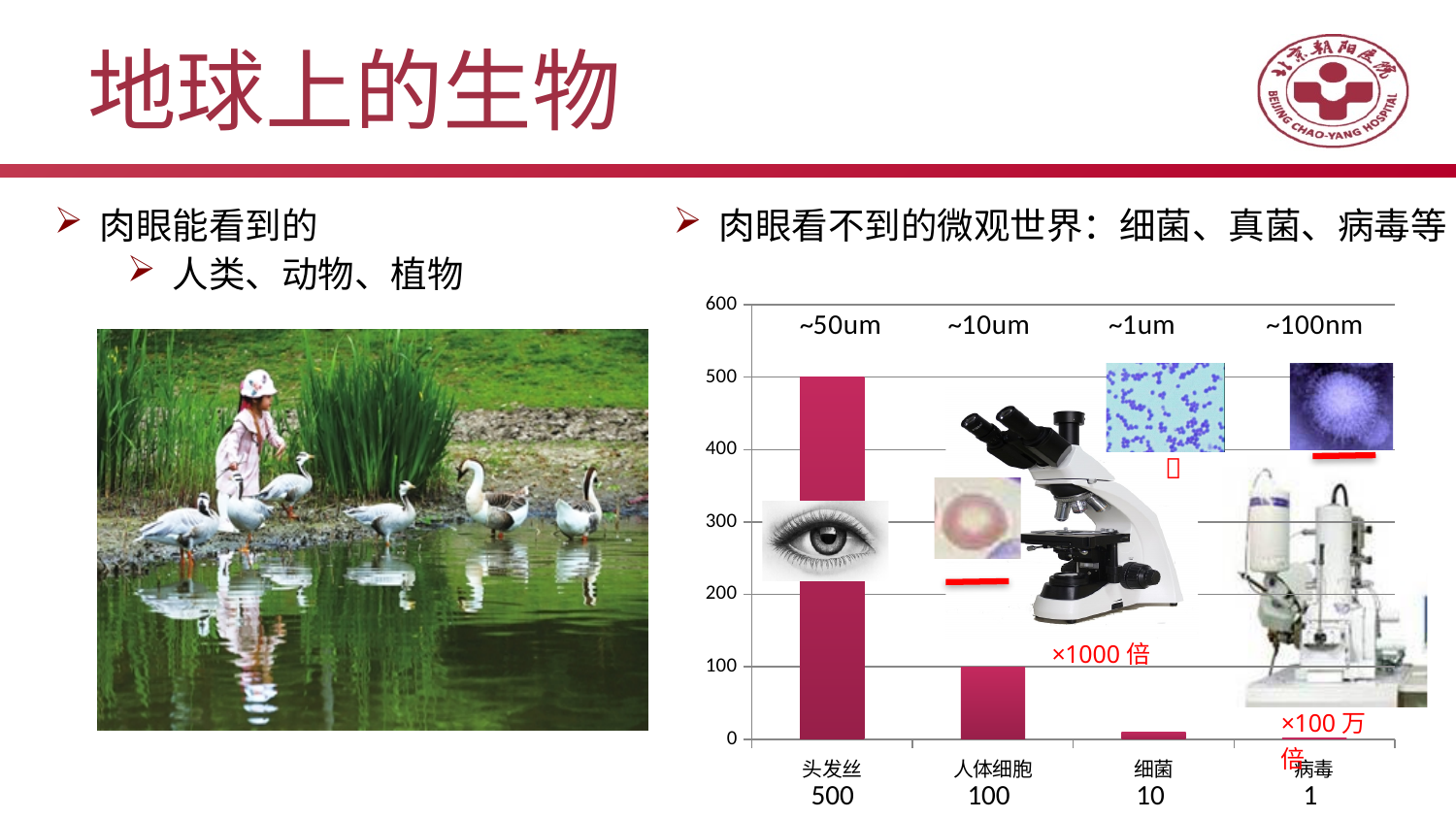
What is the value for 病毒 in the bar chart? 1 What is the value for 人体细胞 in the bar chart? 100 Which category has the lowest value in the bar chart? 病毒 What size annotation is printed above the 细菌 bar? ~1um Do the values rise or fall from left to right along the x axis? fall What type of chart is shown on the slide? bar chart What is the value for 头发丝 in the bar chart? 500 Which category has the highest value in the bar chart? 头发丝 What is the value for 细菌 in the bar chart? 10 What is the difference between the values for 头发丝 and 人体细胞? 400 How many categories does the bar chart show? 4 Which is larger, the value for 人体细胞 or the value for 细菌? 人体细胞